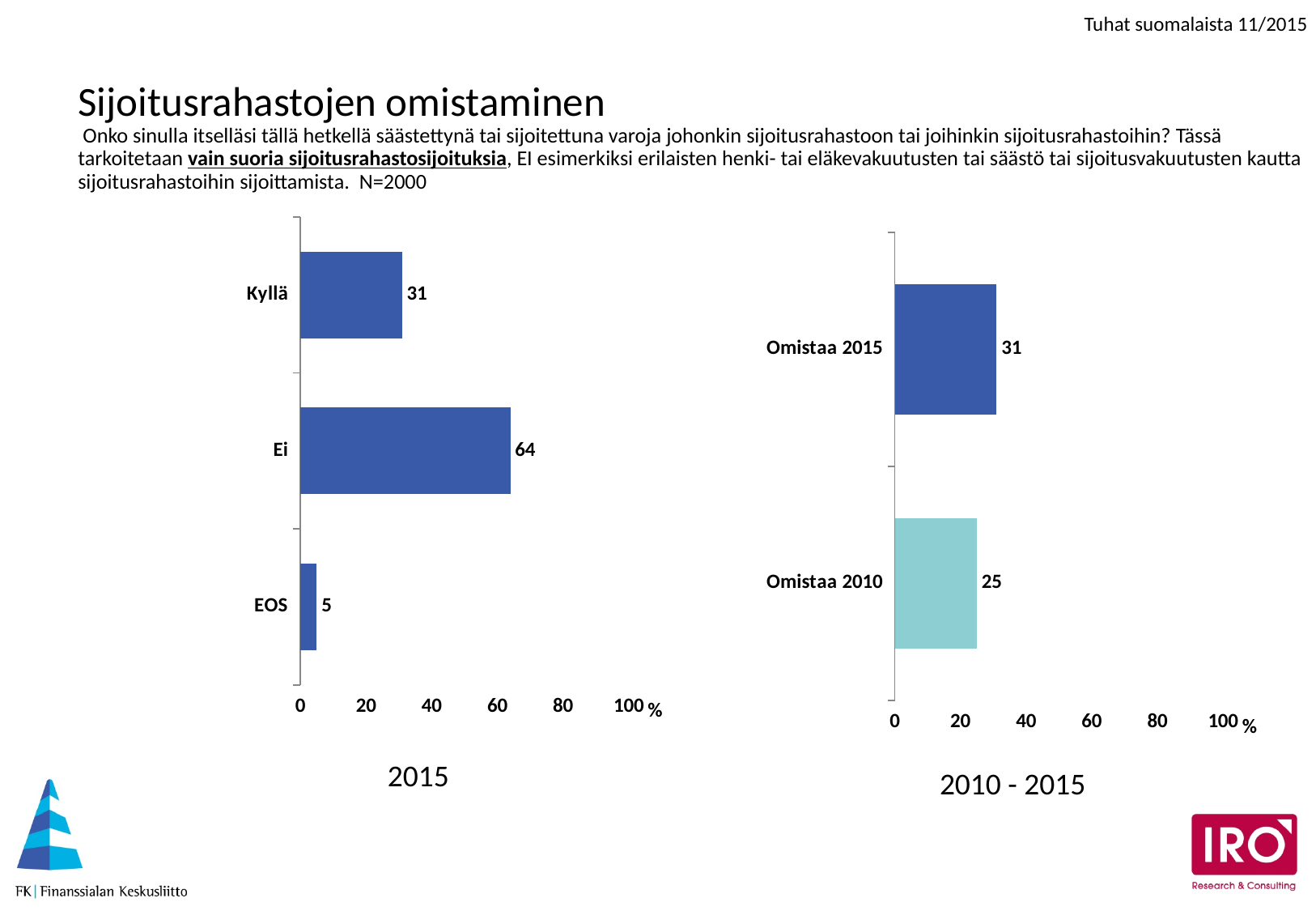
In the right chart (2010 - 2015), which is larger, Omistaa 2015 or Omistaa 2010? Omistaa 2015 In the left chart (2015), what is the difference between the values for Ei and Kyllä? 33 In the left chart (2015), which category has the lowest value? EOS In the right chart (2010 - 2015), what is the value for Omistaa 2010? 25 In the left chart (2015), how many categories are shown? 3 In the left chart (2015), which category has the highest value? Ei In the left chart (2015), what is the value for Kyllä? 31 In the left chart (2015), what is the value for EOS? 5 In the left chart (2015), what is the value for Ei? 64 What kind of chart is the right chart (2010 - 2015)? Bar chart In the right chart (2010 - 2015), what is the difference between Omistaa 2015 and Omistaa 2010? 6 In the right chart (2010 - 2015), what is the value for Omistaa 2015? 31